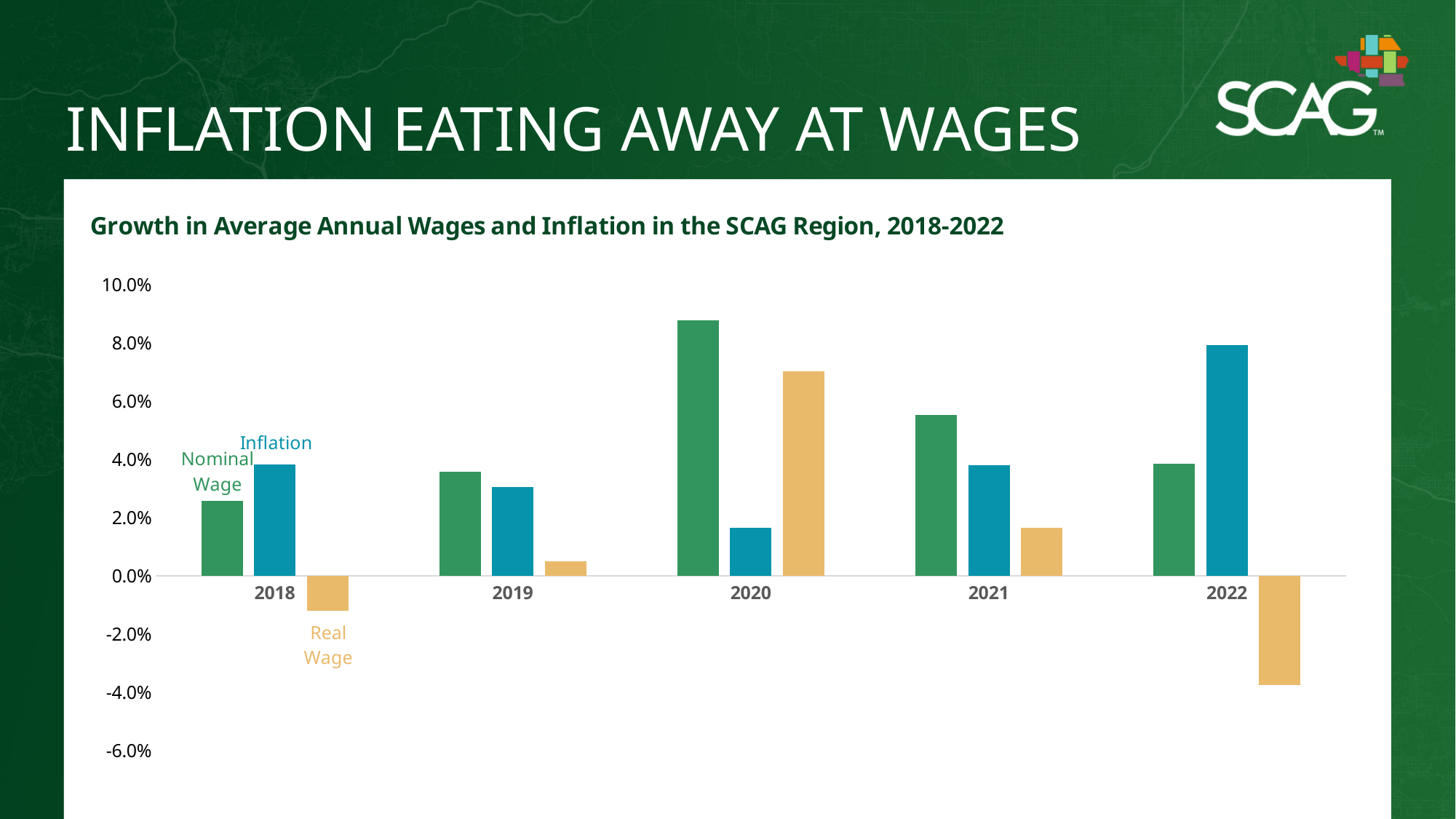
In 2022, which is larger: Nominal Wage or Inflation? Inflation In 2020, which is larger: Nominal Wage or Inflation? Nominal Wage In which year is the Nominal Wage growth highest? 2020 Is the Nominal Wage value for 2020 greater or less than 8.0%? greater What kind of chart is shown on the slide? bar chart In which year is Inflation highest? 2022 What is the title of the chart? Growth in Average Annual Wages and Inflation in the SCAG Region, 2018-2022 Is the Real Wage value for 2022 greater or less than -2.0%? less How many years are shown on the x axis of the chart? 5 In which year is Real Wage growth lowest? 2022 How many data series are plotted in the chart? 3 Is the Inflation value for 2020 greater or less than 2.0%? less